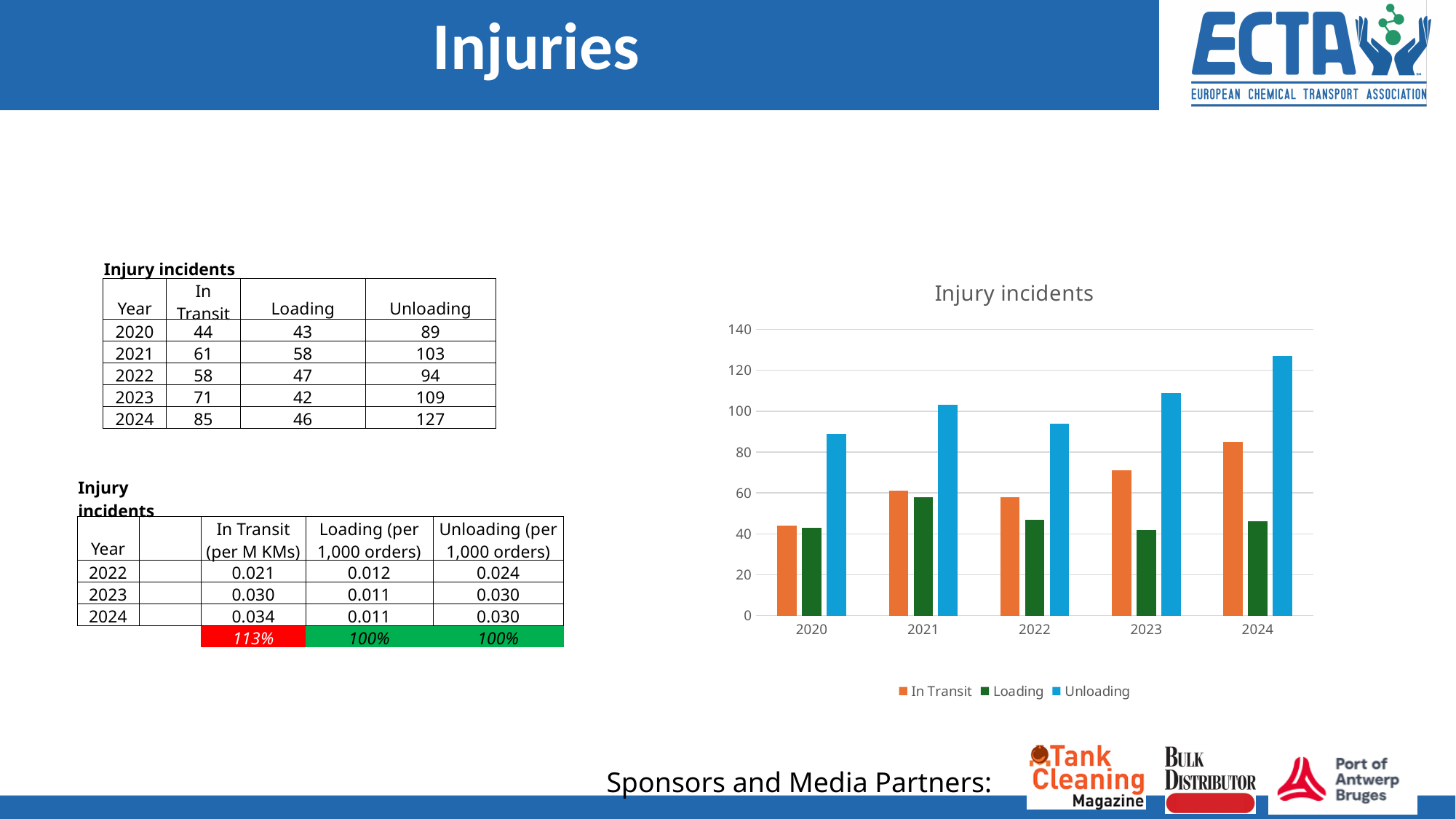
In which year is the In Transit bar the lowest? 2020 Do the In Transit values rise or fall from 2022 to 2024? rise Which is larger in 2022, the In Transit bar or the Loading bar? In Transit What type of chart is shown on the slide? bar chart What is the title of the chart? Injury incidents Is the Loading value for 2023 greater or less than 60? less Which series has the highest bar in every year of the chart? Unloading How many years are shown on the x axis of the chart? 5 How many series does the chart legend list? 3 What colour are the Unloading bars in the chart? light blue Is the Unloading value for 2024 greater or less than 120? greater In which year is the Unloading bar the highest? 2024